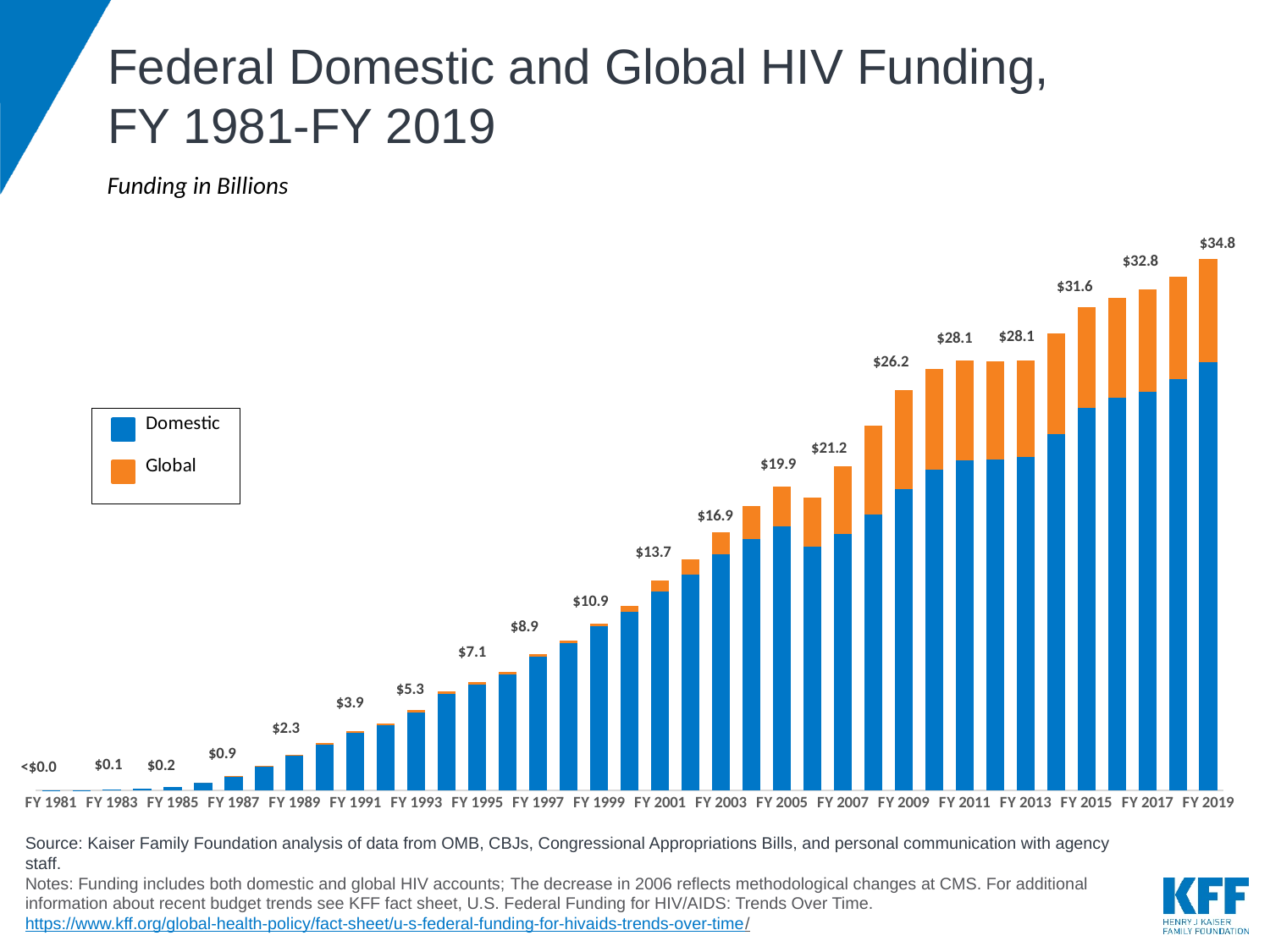
Do total funding values generally rise or fall from FY 1981 to FY 2019? Rise Which colour represents Global funding in the legend? Orange What is the total federal HIV funding shown for FY 2019? $34.8 What is the total funding labeled for FY 1999? $10.9 What is the difference between the total funding in FY 2019 and FY 2017? $2.0 What kind of chart is shown on the slide? Stacked bar chart Which fiscal year has the highest total funding on the chart? FY 2019 Which is larger, the total funding in FY 2005 or FY 2007? FY 2007 How many series does the legend list? 2 What is the difference between the total funding in FY 2009 and FY 2007? $5.0 Which fiscal year has the lowest total funding on the chart? FY 1981 What is the total funding labeled for FY 2009? $26.2